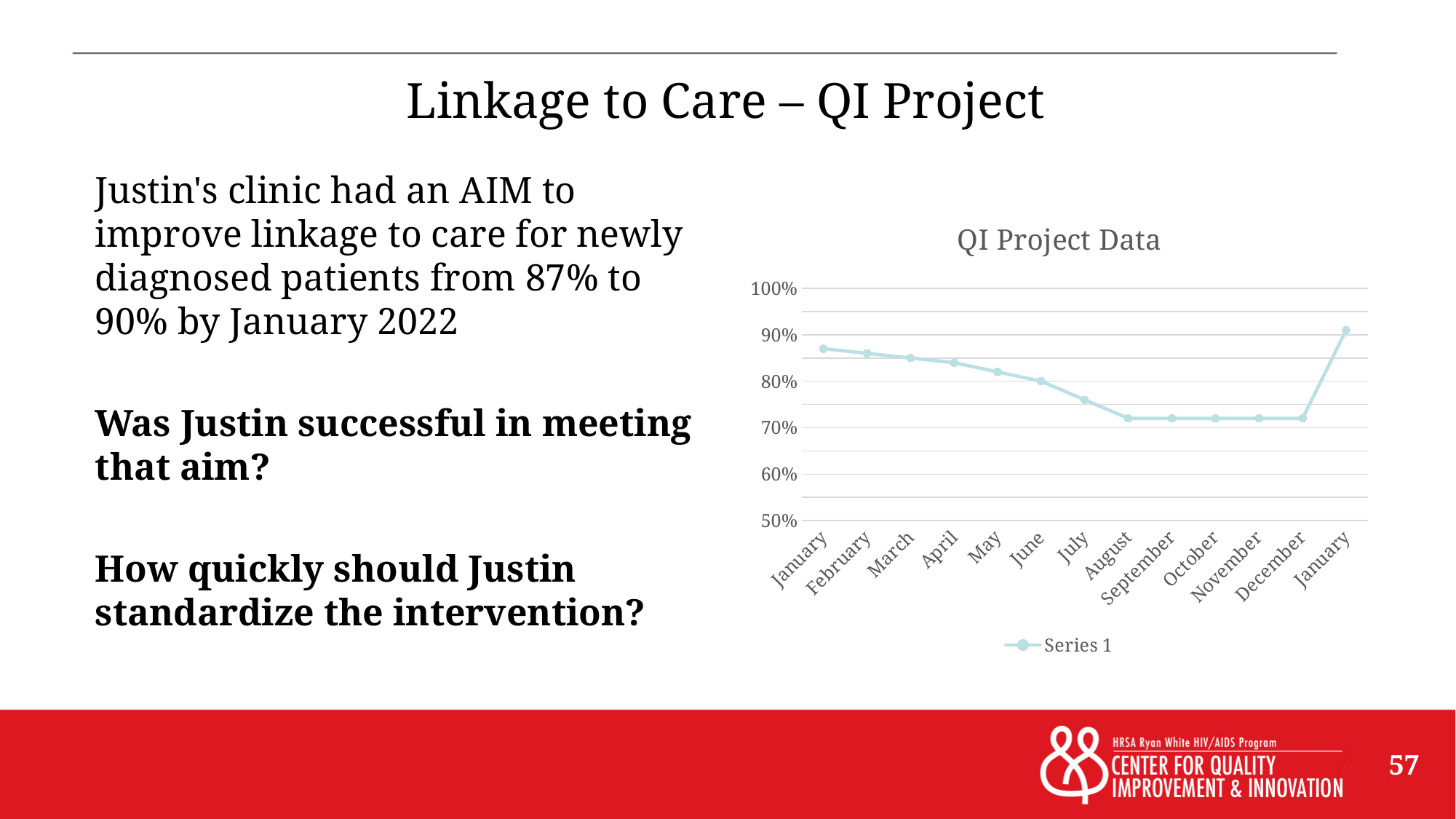
Which is larger, the value for the first January or the value for August? January How many series does the chart legend list? 1 Is the value for August greater or less than 80%? less What is the title of the chart? QI Project Data Is the value for the first January greater or less than 80%? greater Is the value for July greater or less than 80%? less What kind of chart is shown on the slide? Line chart Which month has the highest value on the chart? January (the final point) Do the values rise or fall from the first January through August? fall How many data points are plotted on the chart? 13 What is the name of the series shown in the chart legend? Series 1